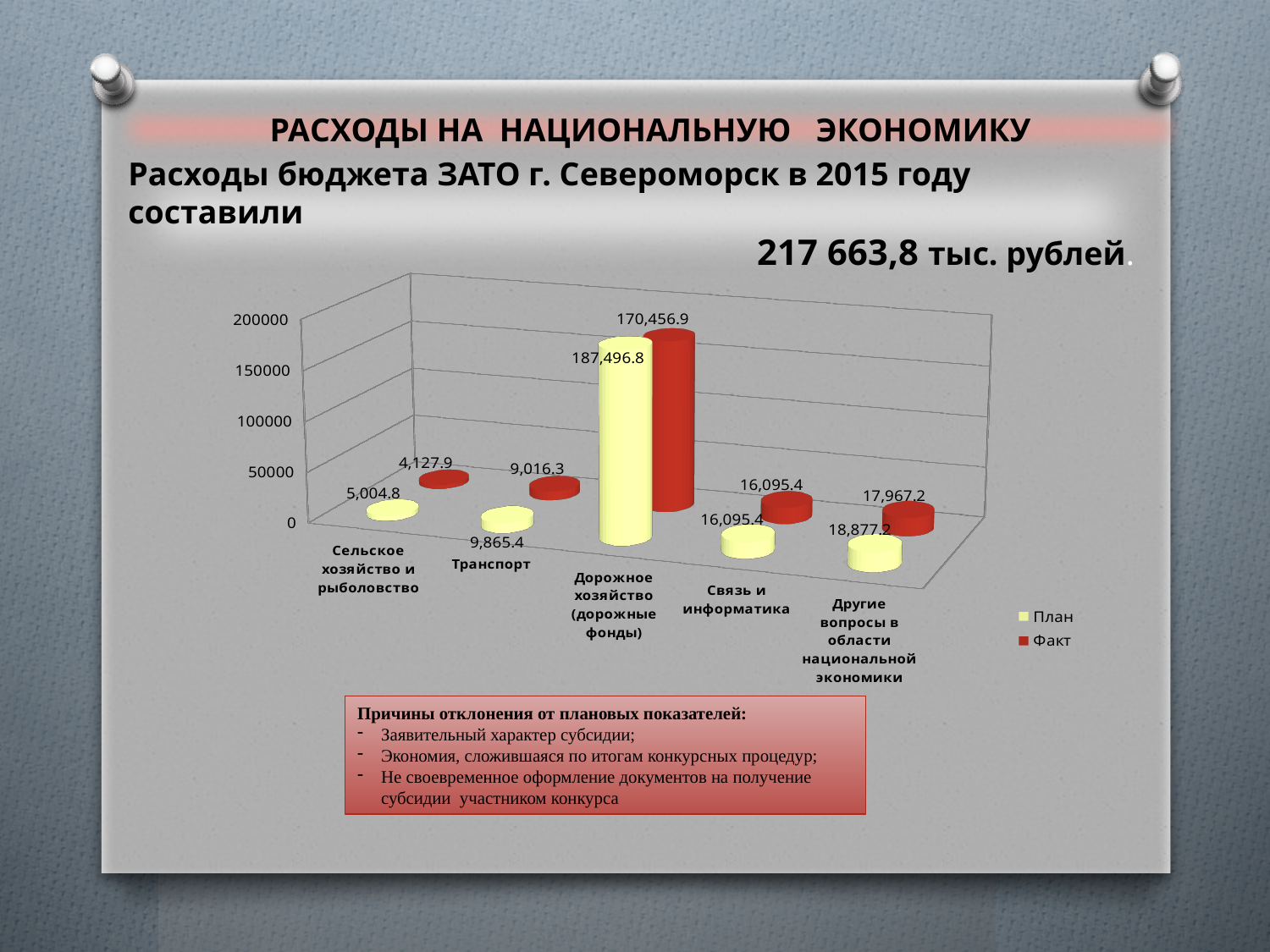
What kind of chart is shown on the slide? Bar chart Which category has the lowest План value? Сельское хозяйство и рыболовство Which category has the highest Факт value? Дорожное хозяйство (дорожные фонды) What is the Факт value for Сельское хозяйство и рыболовство? 4,127.9 What is the Факт value for Дорожное хозяйство (дорожные фонды)? 170,456.9 What is the План value for Транспорт? 9,865.4 How many categories are shown on the x axis? 5 How many series does the legend list? 2 Which is larger for Транспорт, the План value or the Факт value? План What is the difference between the План and Факт values for Дорожное хозяйство (дорожные фонды)? 17,039.9 What is the difference between the План and Факт values for Сельское хозяйство и рыболовство? 876.9 What is the План value for Другие вопросы в области национальной экономики? 18,877.2